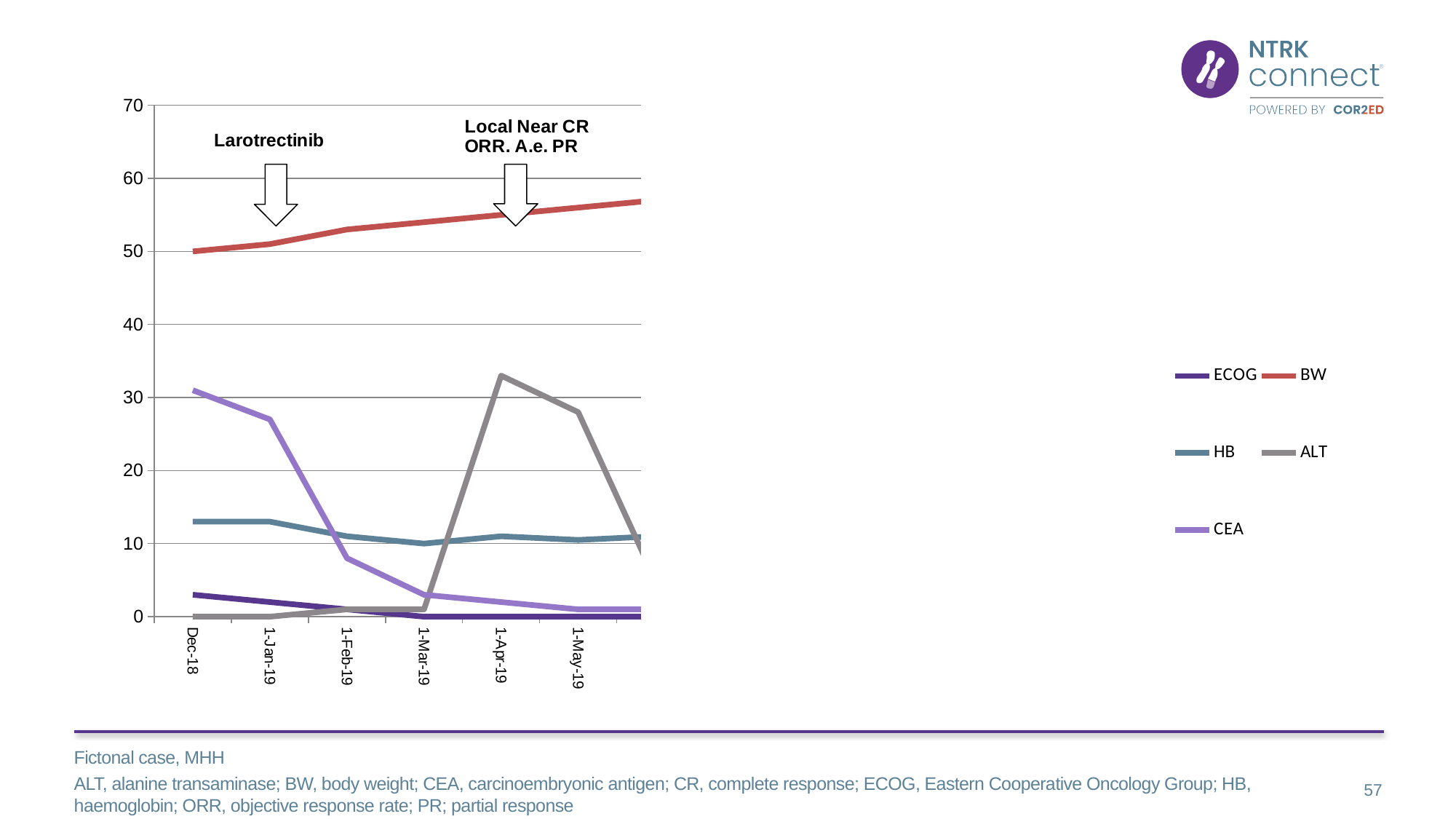
At 1-Apr-19, which is larger: ALT or HB? ALT Is the value for ALT at 1-Apr-19 greater or less than 30? greater Does the CEA series rise or fall from Dec-18 to 1-May-19? falls Is the value for CEA at 1-Feb-19 greater or less than 10? less Which series has the highest value at 1-Apr-19? BW Does the BW series rise or fall from Dec-18 to 1-May-19? rises What kind of chart is shown on the slide? line chart Which series has the lowest value at Dec-18? ALT How many date labels are shown on the x axis? 6 How many series does the legend list? 5 Is the value for HB at Dec-18 greater or less than 10? greater